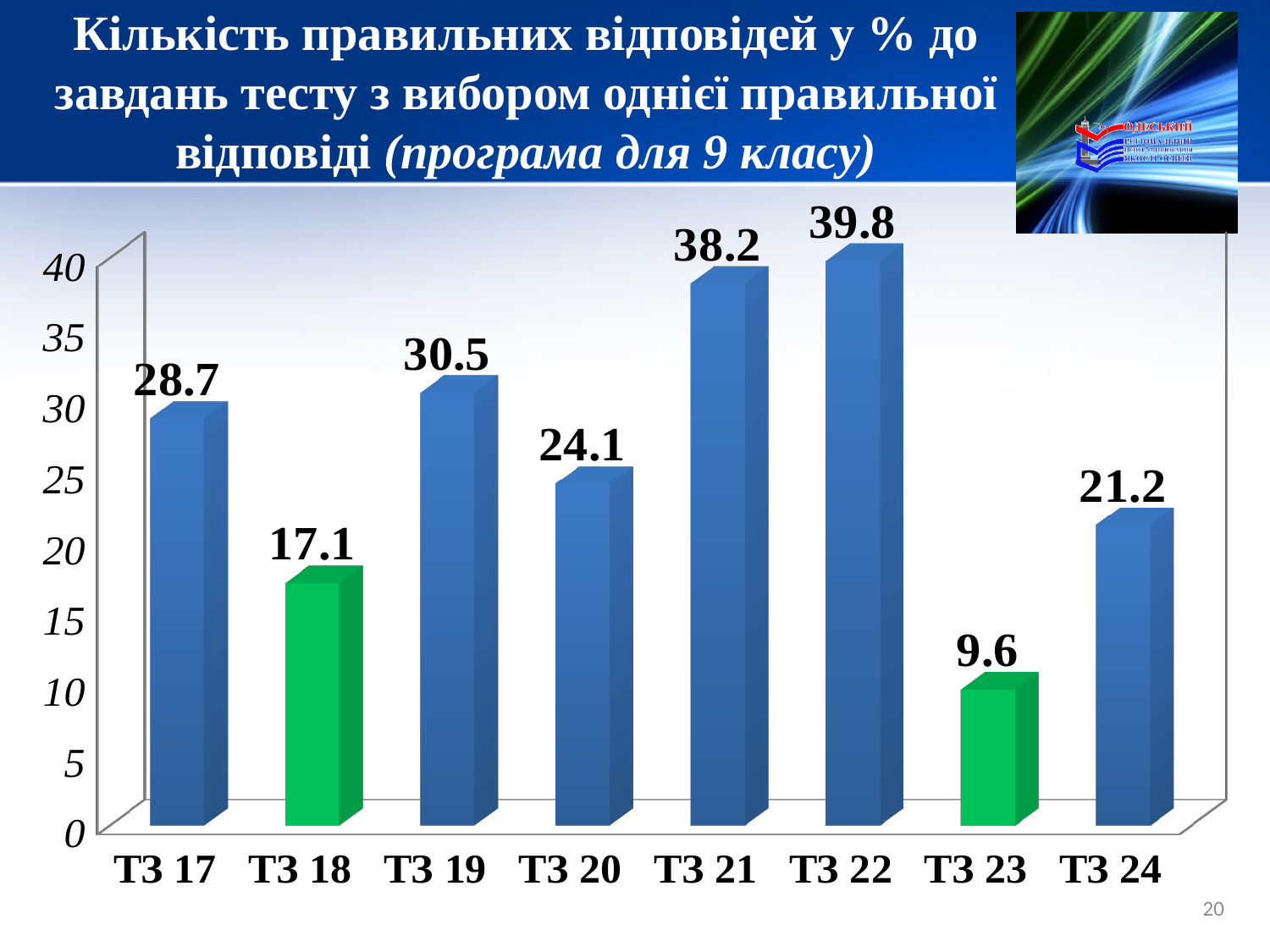
Which is larger, the value for ТЗ 17 or the value for ТЗ 19? ТЗ 19 What kind of chart is shown on the slide? bar chart Which category has the highest value? ТЗ 22 What is the value for ТЗ 18? 17.1 What is the value for ТЗ 24? 21.2 What is the difference between the values for ТЗ 19 and ТЗ 20? 6.4 How many categories are shown on the x axis? 8 What is the difference between the values for ТЗ 22 and ТЗ 23? 30.2 Which category has the lowest value? ТЗ 23 Is the value for ТЗ 20 greater or less than 25? less Which two bars are coloured green rather than blue? ТЗ 18 and ТЗ 23 What is the value for ТЗ 21? 38.2